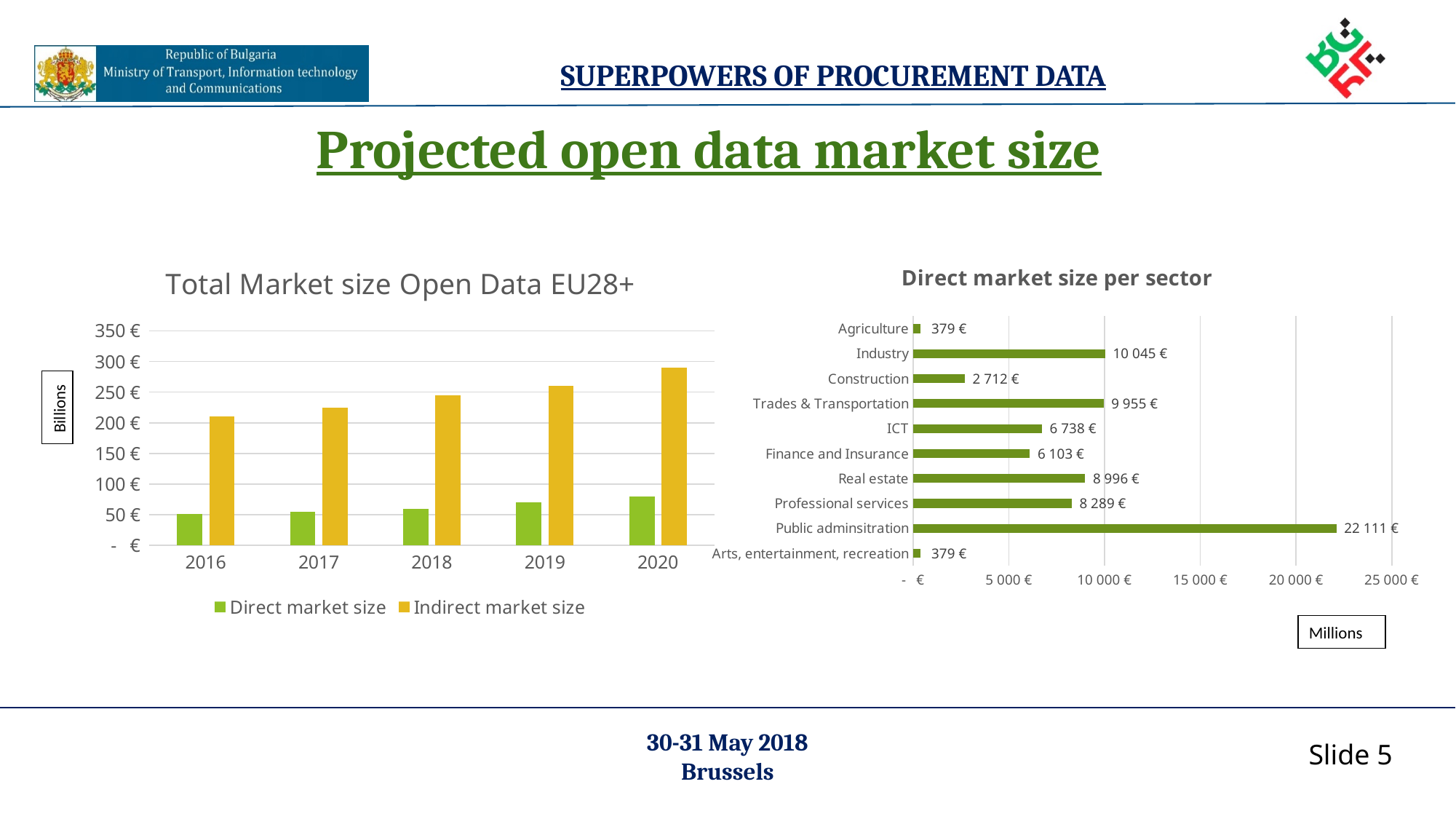
In the 'Total Market size Open Data EU28+' chart, do the Indirect market size values rise or fall from 2016 to 2020? rise What kind of chart is 'Total Market size Open Data EU28+'? Bar chart In the 'Direct market size per sector' chart, which is larger, ICT or Finance and Insurance? ICT In the 'Total Market size Open Data EU28+' chart, is the Direct market size for 2020 greater or less than 50 €? greater In the 'Direct market size per sector' chart, what is the difference between Industry and Trades & Transportation? 90 € How many sectors are shown in the 'Direct market size per sector' chart? 10 In the 'Direct market size per sector' chart, what is the value for Industry? 10 045 € In the 'Direct market size per sector' chart, which sector has the highest value? Public adminsitration In the 'Direct market size per sector' chart, what is the value for Construction? 2 712 € In the 'Total Market size Open Data EU28+' chart, is the Indirect market size for 2020 greater or less than 250 €? greater In the 'Direct market size per sector' chart, what is the value for Real estate? 8 996 € How many series does the legend of the 'Total Market size Open Data EU28+' chart list? 2